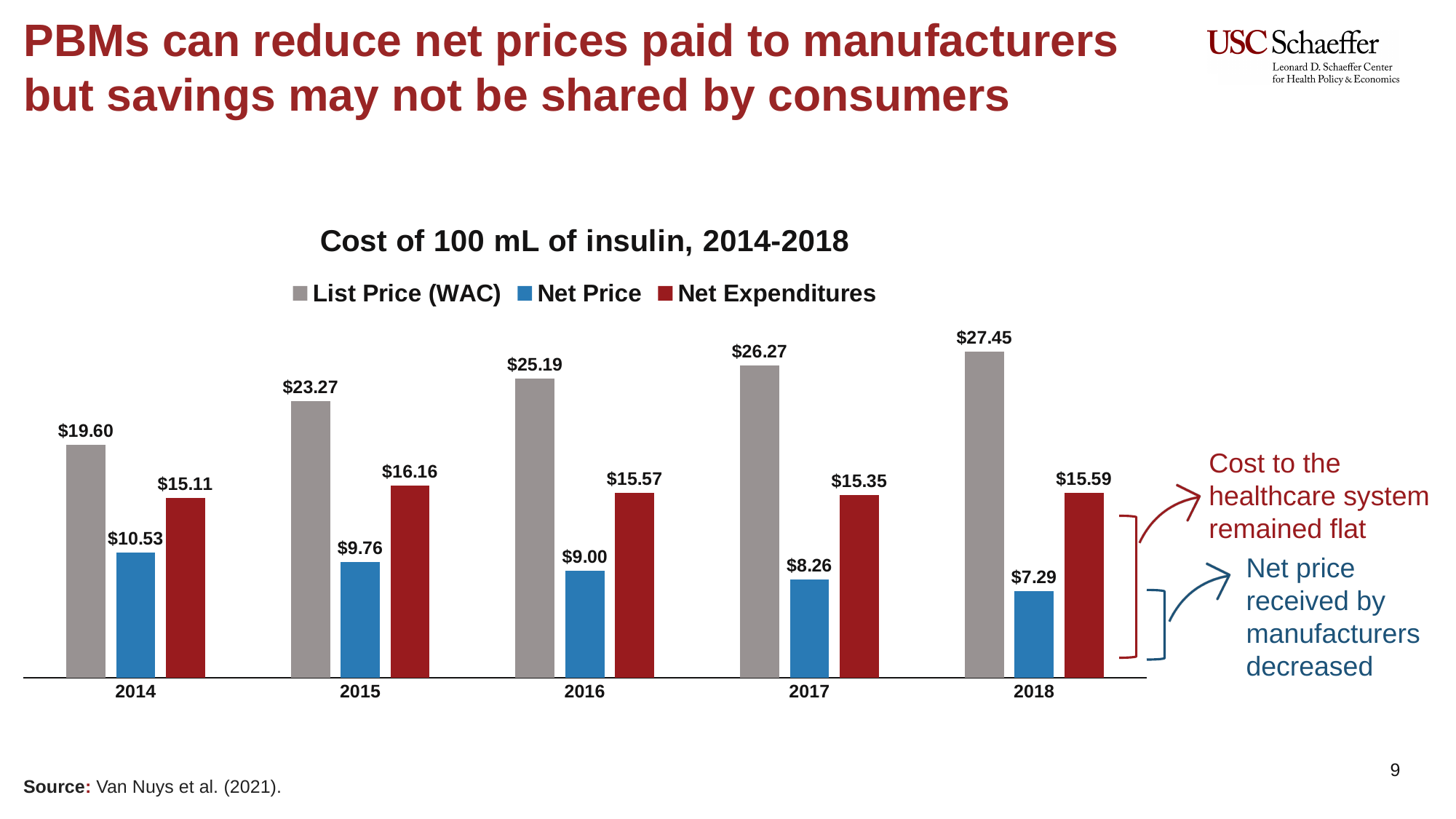
What is the Net Price in 2018? $7.29 What kind of chart is shown? Bar chart Which is larger in 2017: Net Expenditures or Net Price? Net Expenditures Which year has the highest List Price (WAC)? 2018 How many years are shown on the x axis? 5 How many series does the legend list? 3 What is the difference between the List Price (WAC) and the Net Price in 2014? $9.07 Which year has the lowest Net Price? 2018 Does the Net Price rise or fall from 2014 to 2018? Fall What is the List Price (WAC) for 2016? $25.19 What are the Net Expenditures for 2015? $16.16 What is the title of the chart? Cost of 100 mL of insulin, 2014-2018